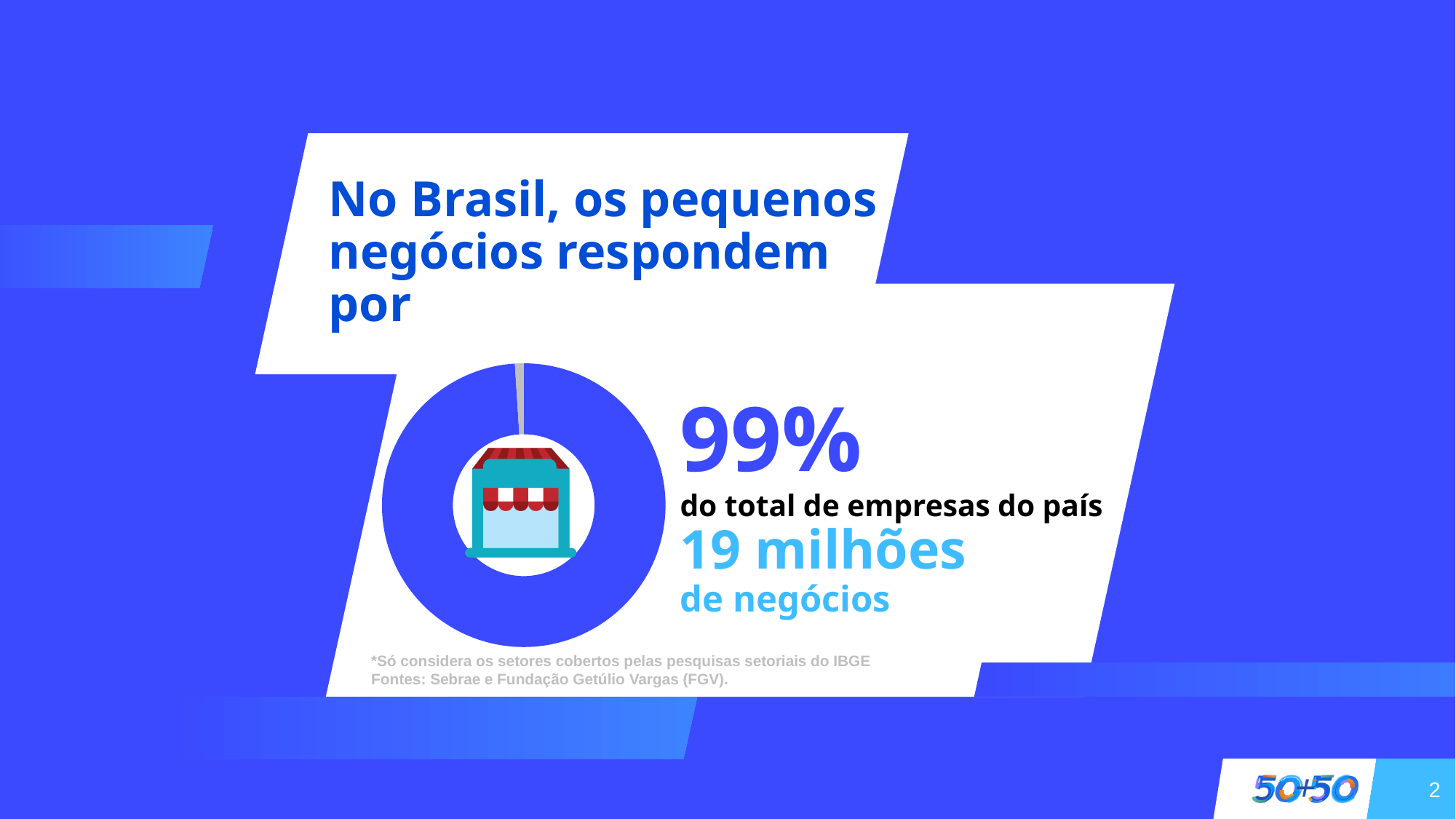
What is the remaining share of companies not covered by the 99% slice? 1% Is the share shown in the donut chart greater or less than 50%? greater What share of the total companies in Brazil do small businesses account for, according to the chart? 99% What is the title text above the chart on the slide? No Brasil, os pequenos negócios respondem por How many businesses does the slide say the 99% corresponds to? 19 milhões What colour is the 99% slice of the donut chart? Blue What kind of chart is used to show the 99% figure on the slide? Donut (pie) chart